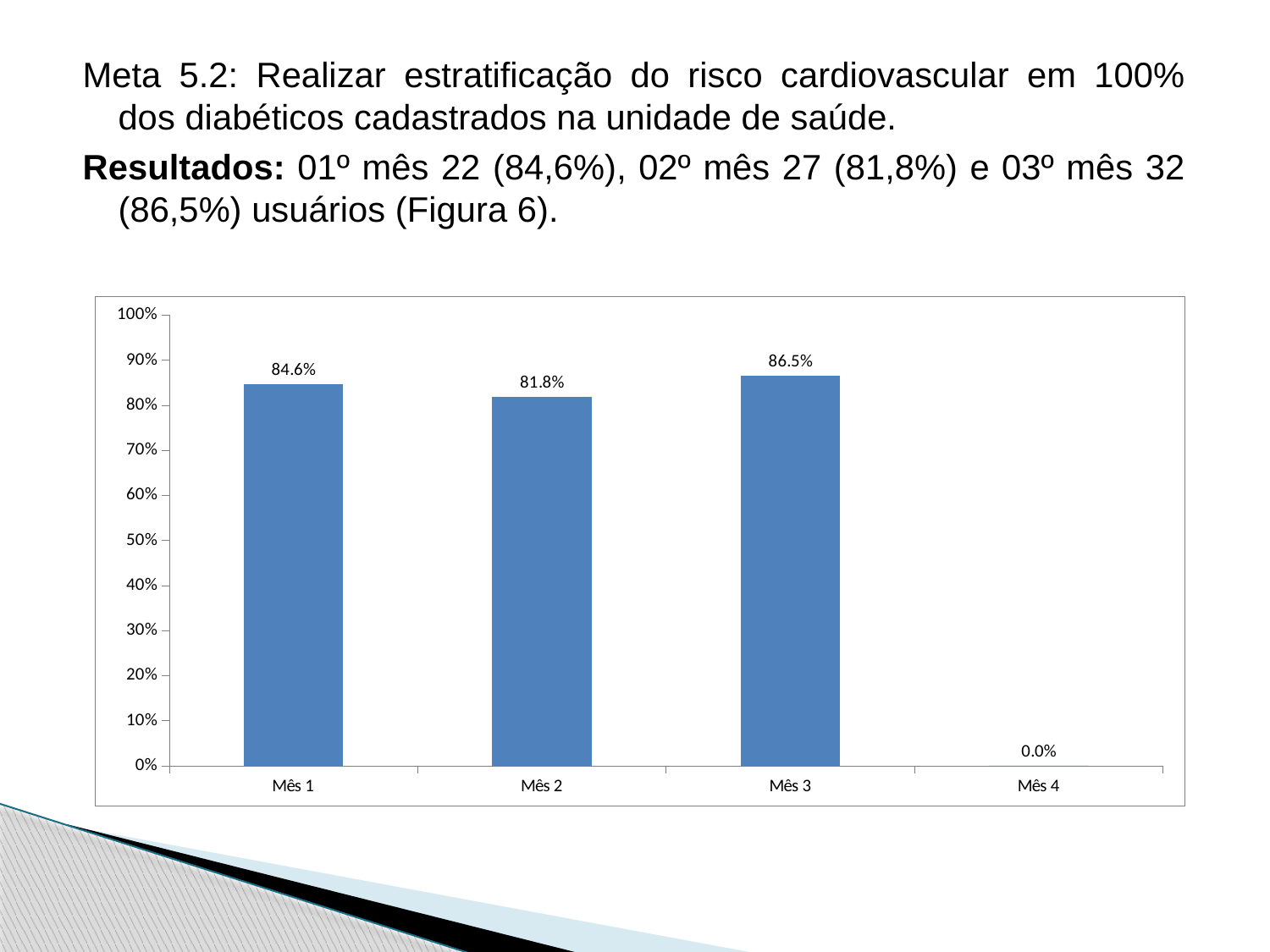
Is the value for Mês 2 greater or less than 80%? greater What is the value for Mês 3? 86.5% How many categories are shown on the x axis? 4 What is the value for Mês 2? 81.8% What is the value for Mês 4? 0.0% What is the highest value shown on the y axis? 100% What is the difference between the values for Mês 3 and Mês 2? 4.7% Which month has the lowest value? Mês 4 What is the value for Mês 1? 84.6% Which is larger, the value for Mês 1 or the value for Mês 2? Mês 1 What kind of chart is shown on the slide? bar chart Which month has the highest value? Mês 3